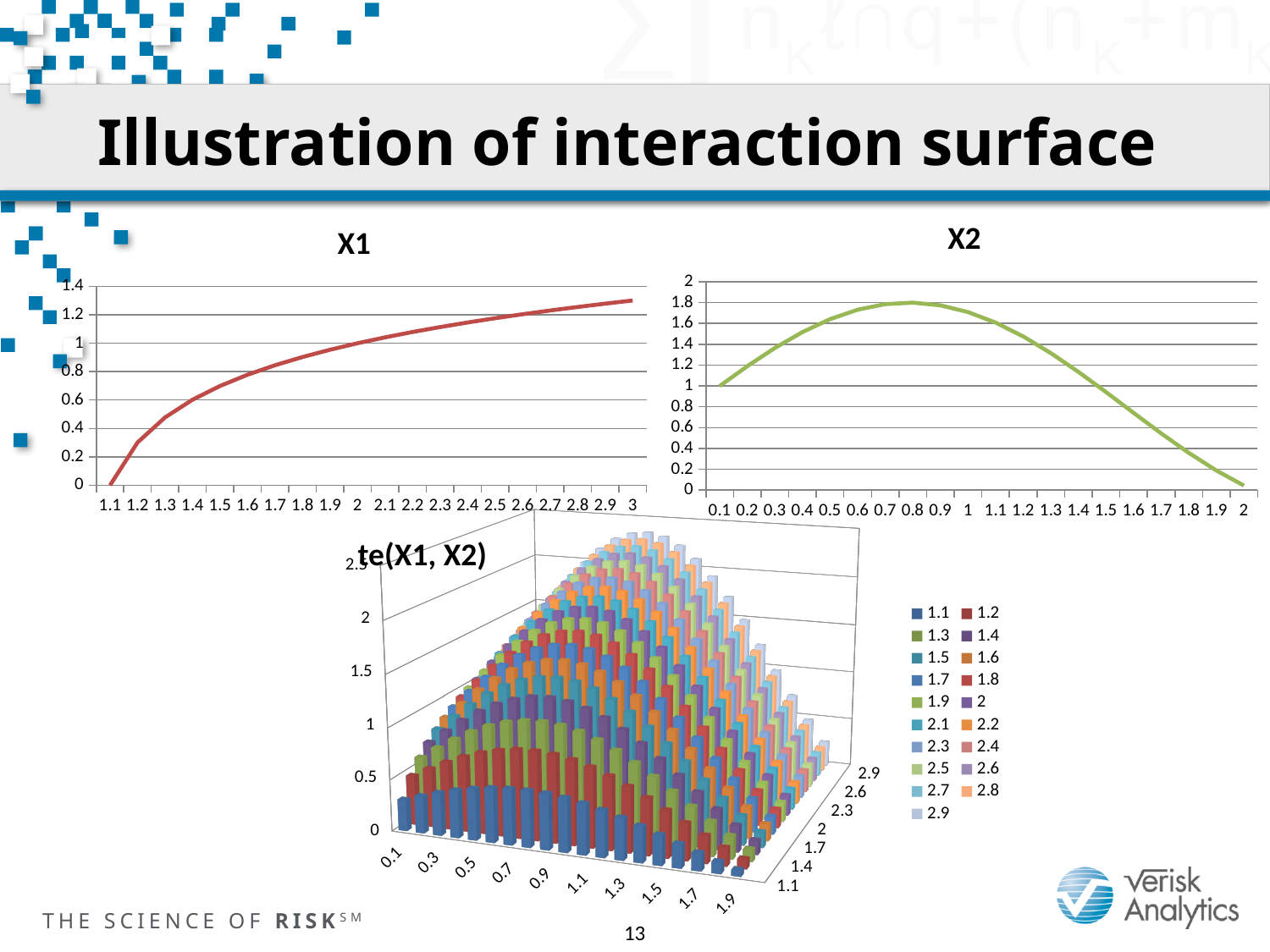
On the X2 chart, which is larger: the value at 0.8 or the value at 2? 0.8 What colour is the line on the X2 chart? green What kind of chart is the te(X1, X2) chart? bar chart On the X2 chart, is the value at 0.8 greater or less than 1.6? greater What kind of chart is the X1 chart? line chart On the X2 chart, is the value at 2 greater or less than 0.2? less On the X1 chart, do the values rise or fall as the x axis goes from 1.1 to 3? rise How many series does the legend of the te(X1, X2) chart list? 19 On the X2 chart, what is the value at 0.1? 1 On the X1 chart, is the value at 1.5 greater or less than 0.8? less How many x-axis points are labelled on the X2 chart? 20